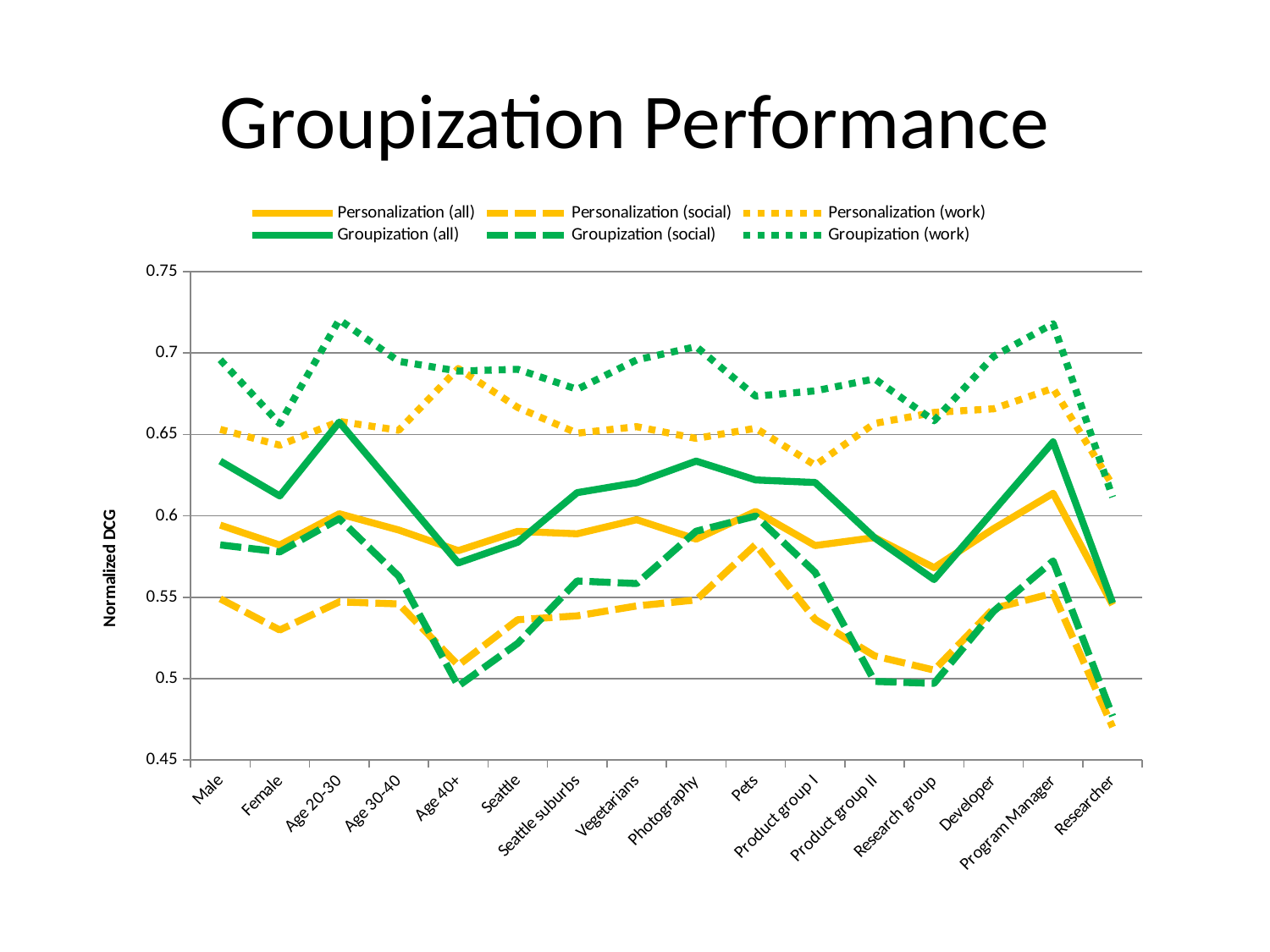
For which category is the Personalization (social) value lowest? Researcher Is the value for Groupization (all) at Program Manager greater or less than 0.6? greater At Male, which is larger: Groupization (all) or Personalization (all)? Groupization (all) Is the value for Personalization (social) at Female greater or less than 0.55? less Is the value for Groupization (work) at Age 20-30 greater or less than 0.7? greater Does the Groupization (work) line rise or fall from Program Manager to Researcher? fall How many series does the legend list? 6 What is the label of the vertical axis? Normalized DCG How many categories are shown along the x axis? 16 What kind of chart is shown on the slide? line chart